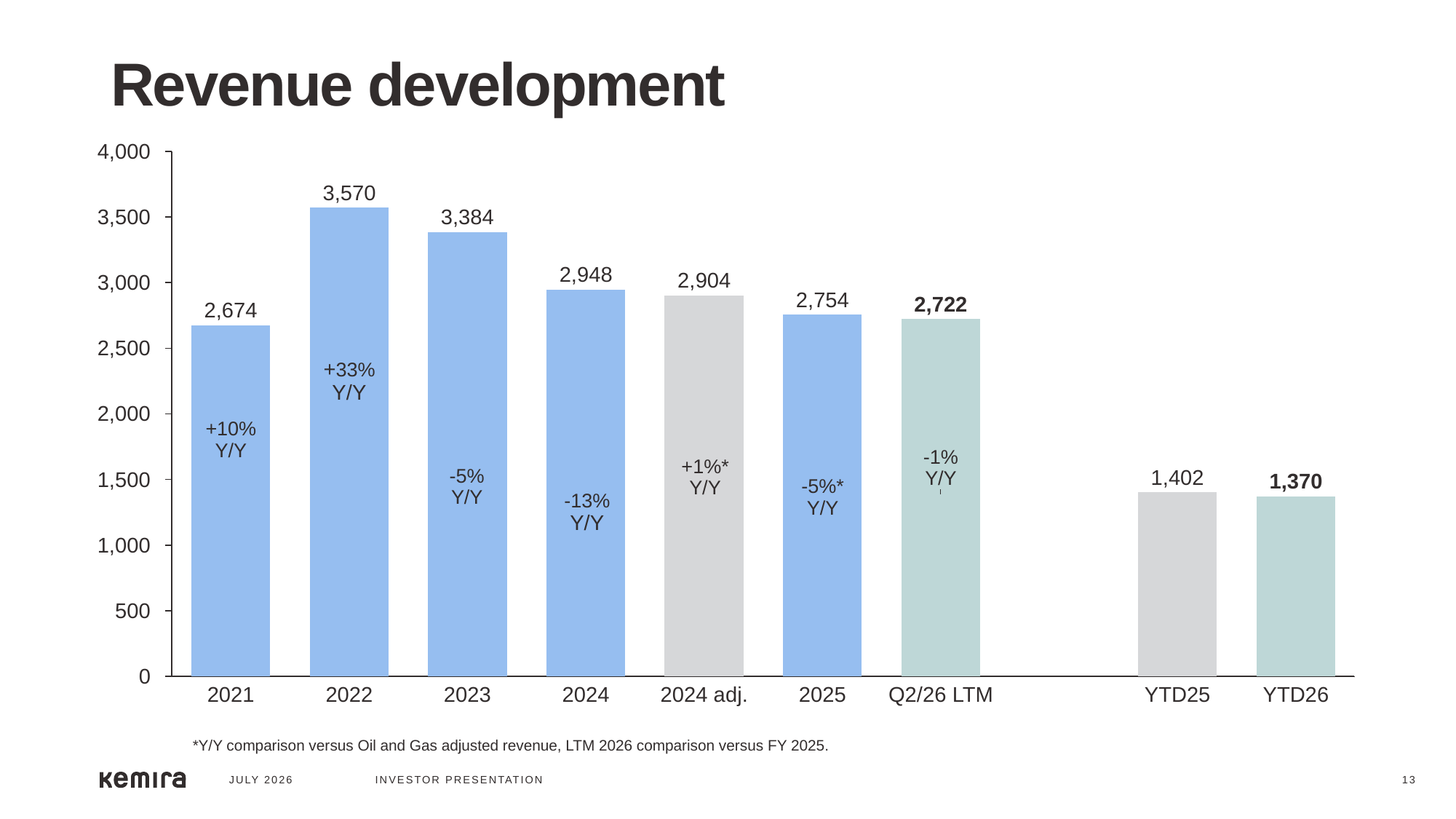
What is the revenue value shown for Q2/26 LTM? 2,722 Is the value for 2021 greater or less than 2,500? greater Which category has the highest revenue bar? 2022 What is the revenue value shown for YTD26? 1,370 What kind of chart is shown on the slide? bar chart What is the difference between the YTD25 and YTD26 revenue values? 32 Which category has the lowest revenue bar? YTD26 Which is larger, the revenue for 2024 or for 2024 adj.? 2024 What Y/Y change is printed on the 2022 bar? +33% Y/Y What is the revenue value shown for 2022? 3,570 What is the difference between the 2022 and 2023 revenue values? 186 How many bars are plotted on the chart? 9